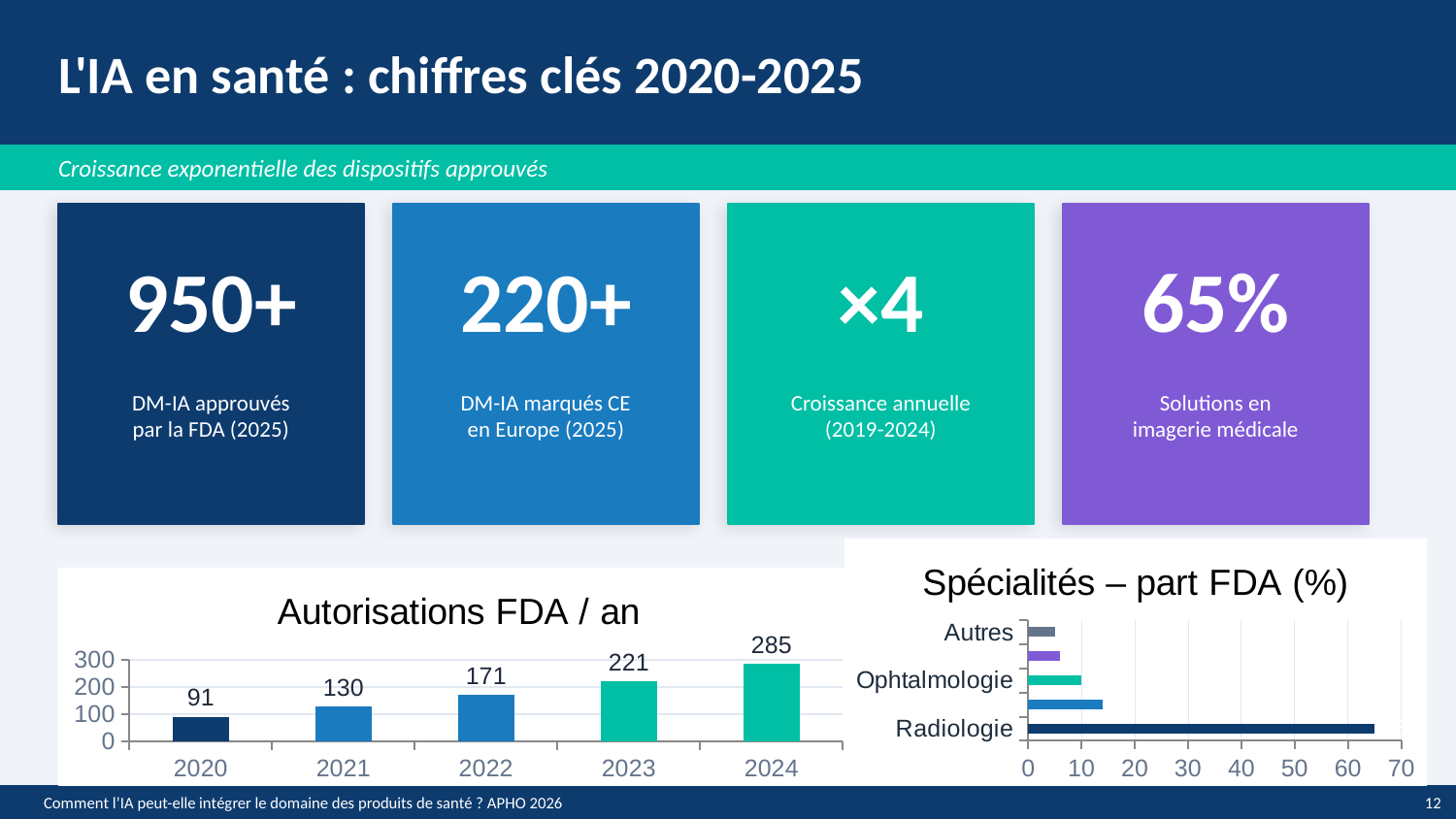
In the chart 'Autorisations FDA / an', how many years are shown on the x axis? 5 In the chart 'Spécialités – part FDA (%)', is the value for Ophtalmologie greater or less than 20? less In the chart 'Autorisations FDA / an', which year has the highest value? 2024 In the chart 'Autorisations FDA / an', what is the difference between the values for 2024 and 2023? 64 In the chart 'Autorisations FDA / an', do the values rise or fall from 2020 to 2024? rise In the chart 'Spécialités – part FDA (%)', is the value for Radiologie greater or less than 60? greater In the chart 'Spécialités – part FDA (%)', which is larger, the value for Radiologie or the value for Autres? Radiologie In the chart 'Autorisations FDA / an', which is larger, the value for 2021 or the value for 2022? 2022 What kind of chart is 'Autorisations FDA / an'? bar chart In the chart 'Autorisations FDA / an', what is the value for 2022? 171 In the chart 'Autorisations FDA / an', what is the value for 2020? 91 In the chart 'Autorisations FDA / an', which year has the lowest value? 2020